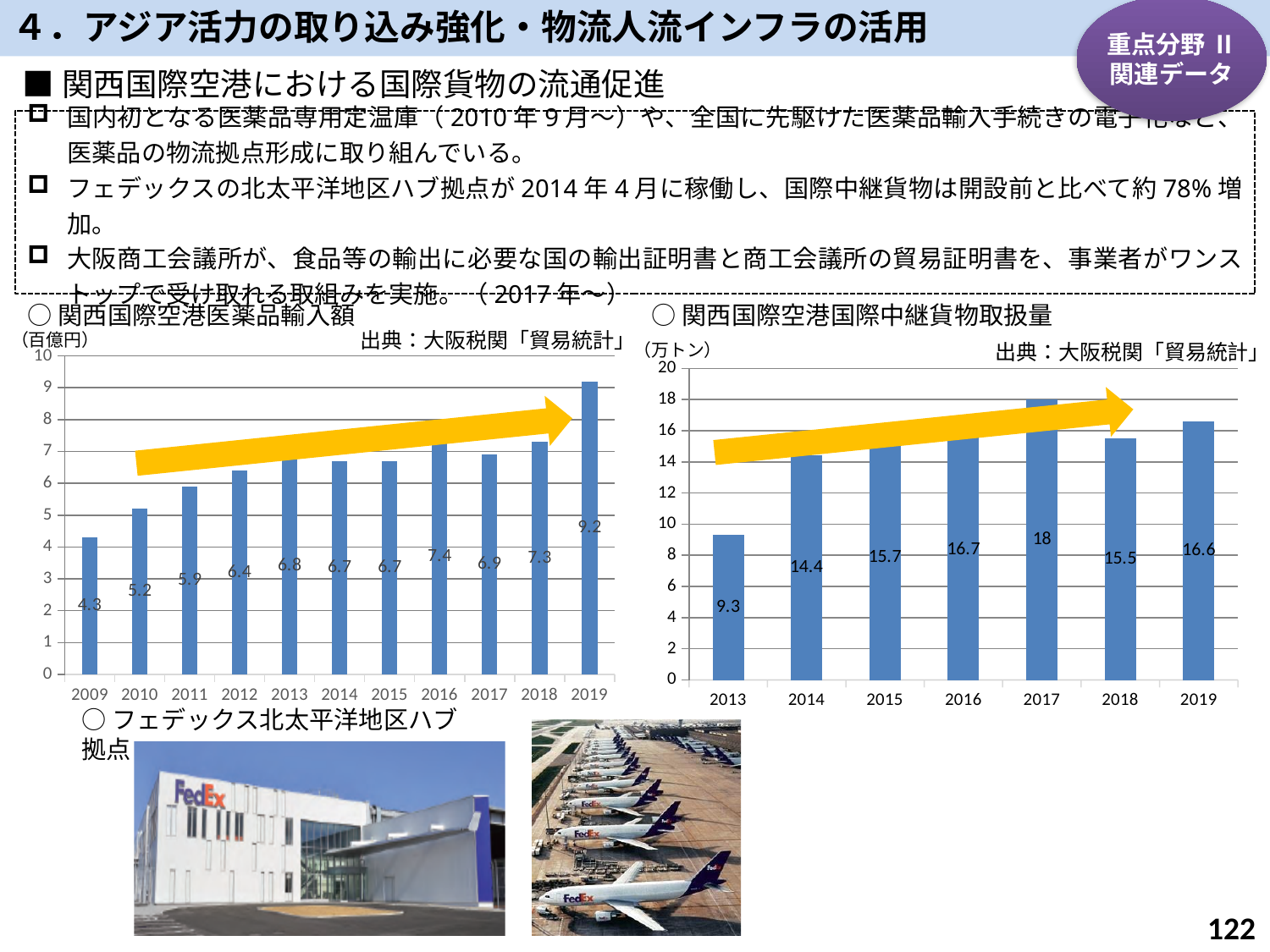
What type of chart is the 関西国際空港国際中継貨物取扱量 chart? Bar chart In the 関西国際空港医薬品輸入額 chart, what is the value for 2019? 9.2 In the 関西国際空港医薬品輸入額 chart, what is the value for 2009? 4.3 In the 関西国際空港国際中継貨物取扱量 chart, what is the difference between the 2014 and 2013 values? 5.1 In the 関西国際空港国際中継貨物取扱量 chart, which is larger, the value for 2018 or the value for 2019? 2019 In the 関西国際空港国際中継貨物取扱量 chart, which year has the lowest value? 2013 In the 関西国際空港医薬品輸入額 chart, what is the unit shown on the y axis? 百億円 In the 関西国際空港医薬品輸入額 chart, what is the difference between the 2019 and 2018 values? 1.9 In the 関西国際空港国際中継貨物取扱量 chart, what is the value for 2017? 18 In the 関西国際空港医薬品輸入額 chart, how many years are shown on the x axis? 11 In the 関西国際空港国際中継貨物取扱量 chart, which year has the highest value? 2017 In the 関西国際空港医薬品輸入額 chart, which year has the lowest value? 2009